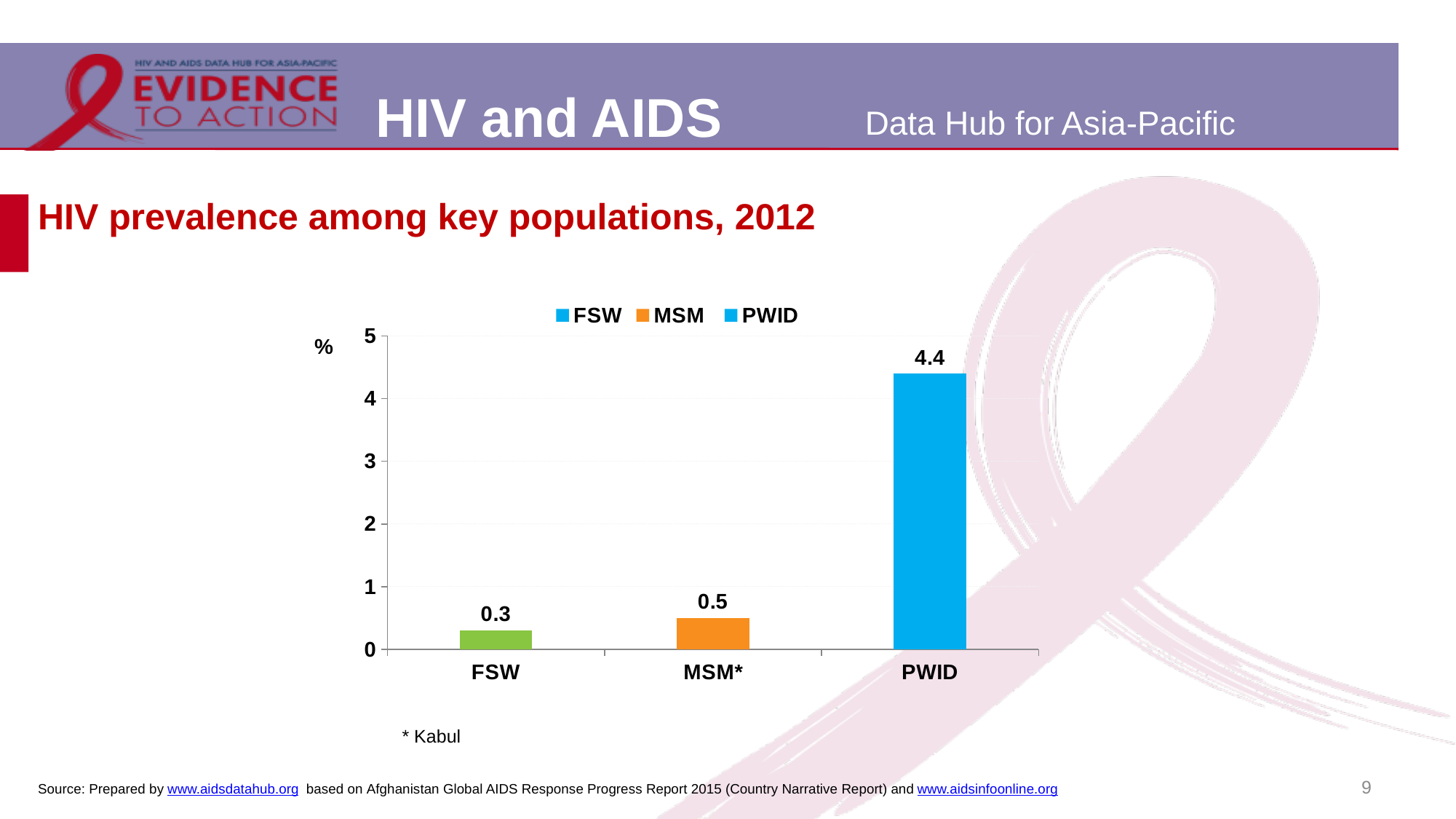
What does the asterisk next to MSM refer to, according to the note below the chart? Kabul How many key populations are shown on the chart? 3 What is the difference between the HIV prevalence for PWID and for MSM*? 3.9 Which has a higher HIV prevalence, FSW or MSM*? MSM* What kind of chart is shown on the slide? bar chart What is the HIV prevalence value shown for MSM*? 0.5 Which key population has the lowest HIV prevalence on the chart? FSW What is the HIV prevalence value shown for PWID? 4.4 Is the value for PWID greater or less than 4? greater What is the HIV prevalence value shown for FSW? 0.3 What is the difference between the HIV prevalence for MSM* and for FSW? 0.2 Which key population has the highest HIV prevalence on the chart? PWID